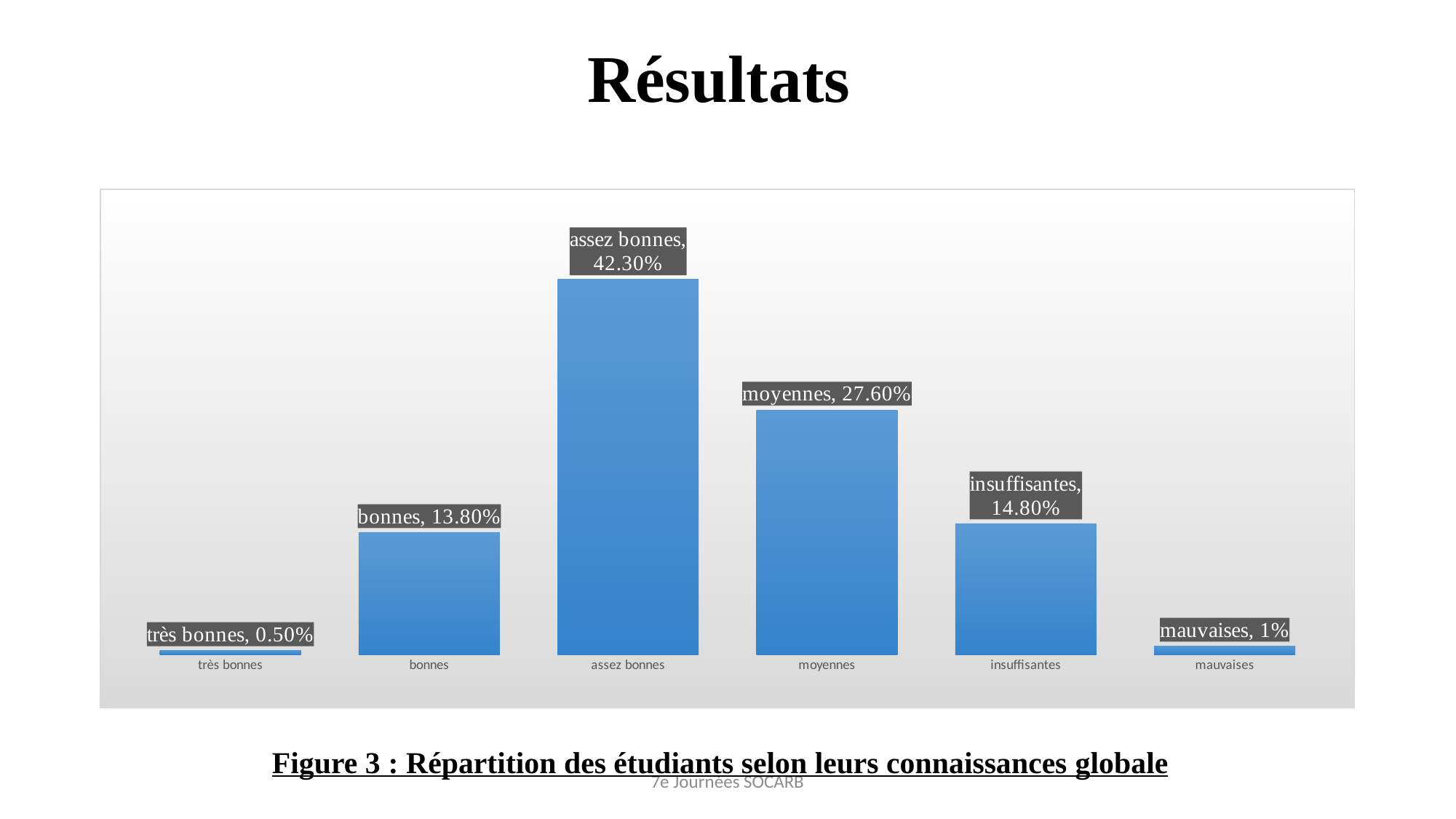
What is the difference between the values for "insuffisantes" and "bonnes"? 1.00% How many categories are shown in the chart? 6 Which category has the highest value? assez bonnes What kind of chart is shown on the slide? bar chart Which is larger, the value for "bonnes" or the value for "insuffisantes"? insuffisantes What is the difference between the values for "assez bonnes" and "moyennes"? 14.70% What is the value for "insuffisantes"? 14.80% What is the value for "très bonnes"? 0.50% Which category has the lowest value? très bonnes What is the value for "assez bonnes"? 42.30% What is the value for "mauvaises"? 1% What is the value for "moyennes"? 27.60%